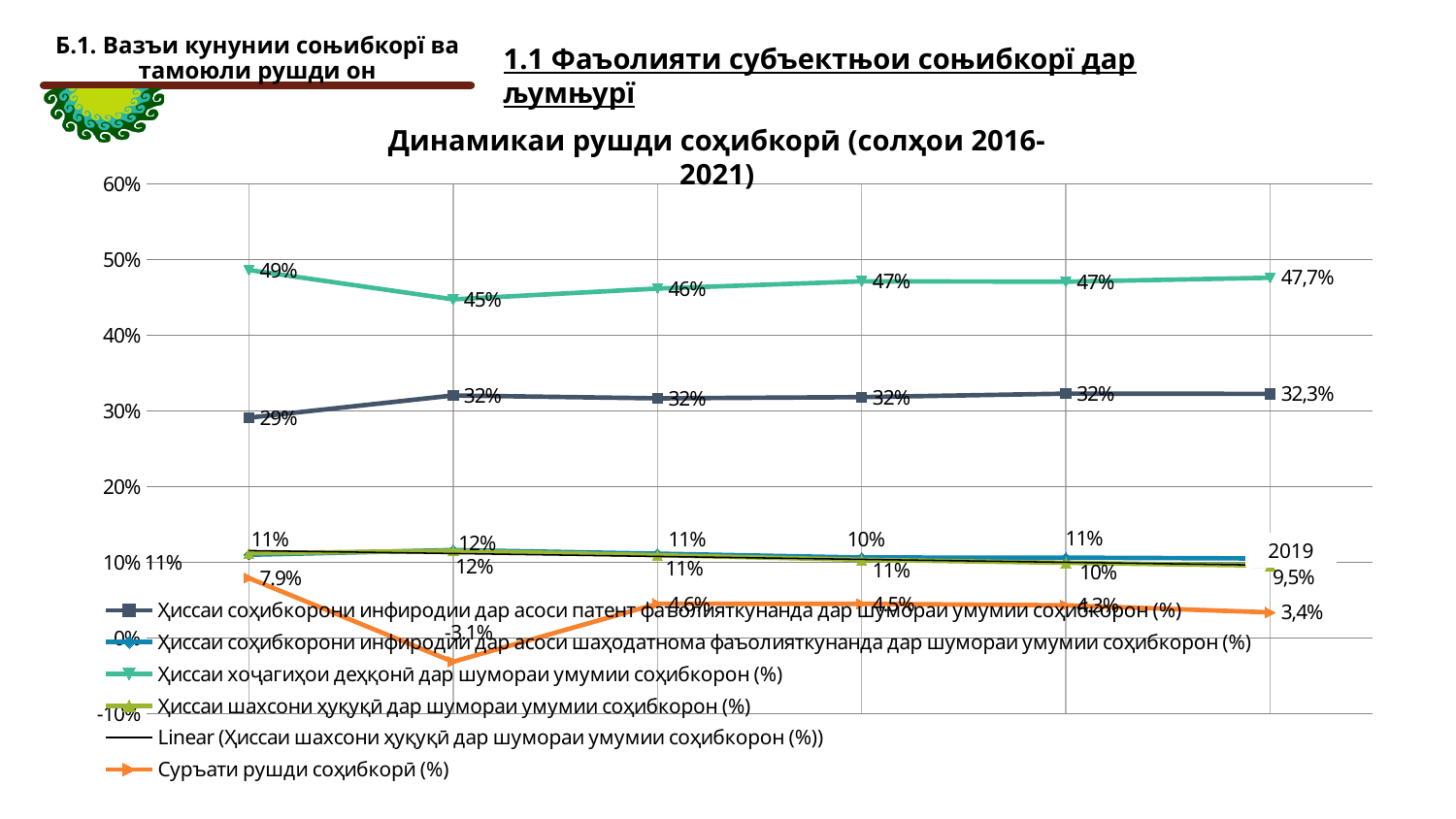
What kind of chart is shown on the slide? line chart What is the first (leftmost) value of the series 'Ҳиссаи хоҷагиҳои деҳқонӣ дар шумораи умумии соҳибкорон (%)'? 49% What is the lowest value of the series 'Суръати рушди соҳибкорӣ (%)'? -3,1% What is the lowest value of the series 'Ҳиссаи хоҷагиҳои деҳқонӣ дар шумораи умумии соҳибкорон (%)'? 45% Which series has the highest values throughout the chart: 'Ҳиссаи хоҷагиҳои деҳқонӣ дар шумораи умумии соҳибкорон (%)' or 'Ҳиссаи соҳибкорони инфиродии дар асоси патент фаъолияткунанда дар шумораи умумии соҳибкорон (%)'? Ҳиссаи хоҷагиҳои деҳқонӣ дар шумораи умумии соҳибкорон (%) What is the last (rightmost) value of the series 'Ҳиссаи хоҷагиҳои деҳқонӣ дар шумораи умумии соҳибкорон (%)'? 47,7% How many series does the legend list? 6 What is the last (rightmost) value of the series 'Ҳиссаи соҳибкорони инфиродии дар асоси патент фаъолияткунанда дар шумораи умумии соҳибкорон (%)'? 32,3% What is the first (leftmost) value of the series 'Ҳиссаи соҳибкорони инфиродии дар асоси патент фаъолияткунанда дар шумораи умумии соҳибкорон (%)'? 29% What is the last (rightmost) value of the series 'Суръати рушди соҳибкорӣ (%)'? 3,4% How many data points does each line in the chart have? 6 What is the title of the chart? Динамикаи рушди соҳибкорӣ (солҳои 2016-2021)